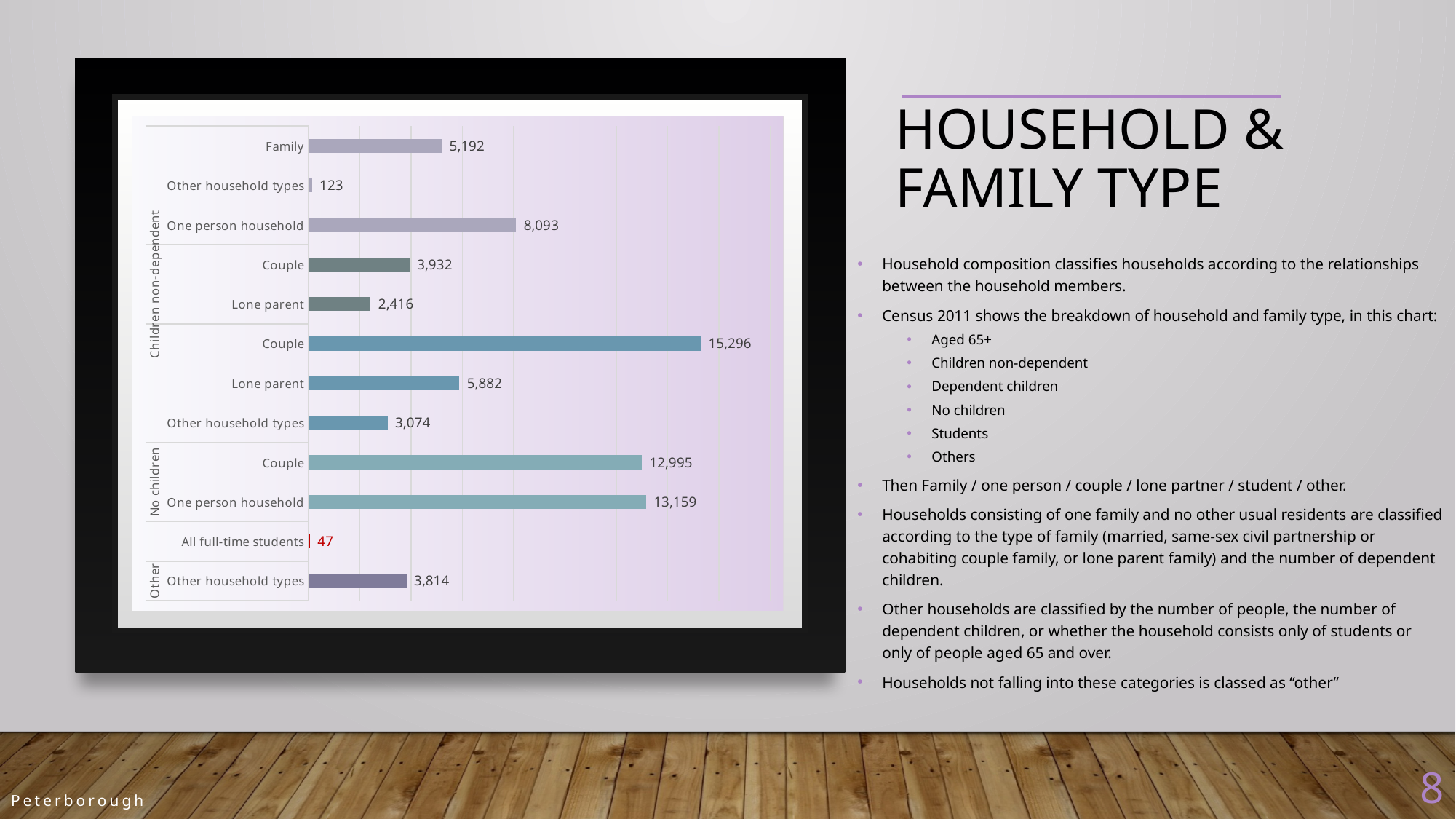
What kind of chart is shown on the slide? Bar chart Which bar in the chart has the lowest value? All full-time students (47) What is the value for All full-time students in the chart? 47 How many bars are plotted in the chart? 12 In the No children group, what is the difference between One person household (13,159) and Couple (12,995)? 164 Which group label is shown beside the Couple (12,995) and One person household (13,159) bars? No children What is the value for Lone parent in the Children non-dependent group? 2,416 Which bar in the chart has the highest value? Couple (15,296) What is the difference between the Family bar (5,192) and the Other household types bar directly below it (123)? 5,069 Which is larger: the Family bar or the Lone parent bar in the Children non-dependent group? Family What is the value for Other household types in the Other group at the bottom of the chart? 3,814 What is the value for Family in the chart? 5,192